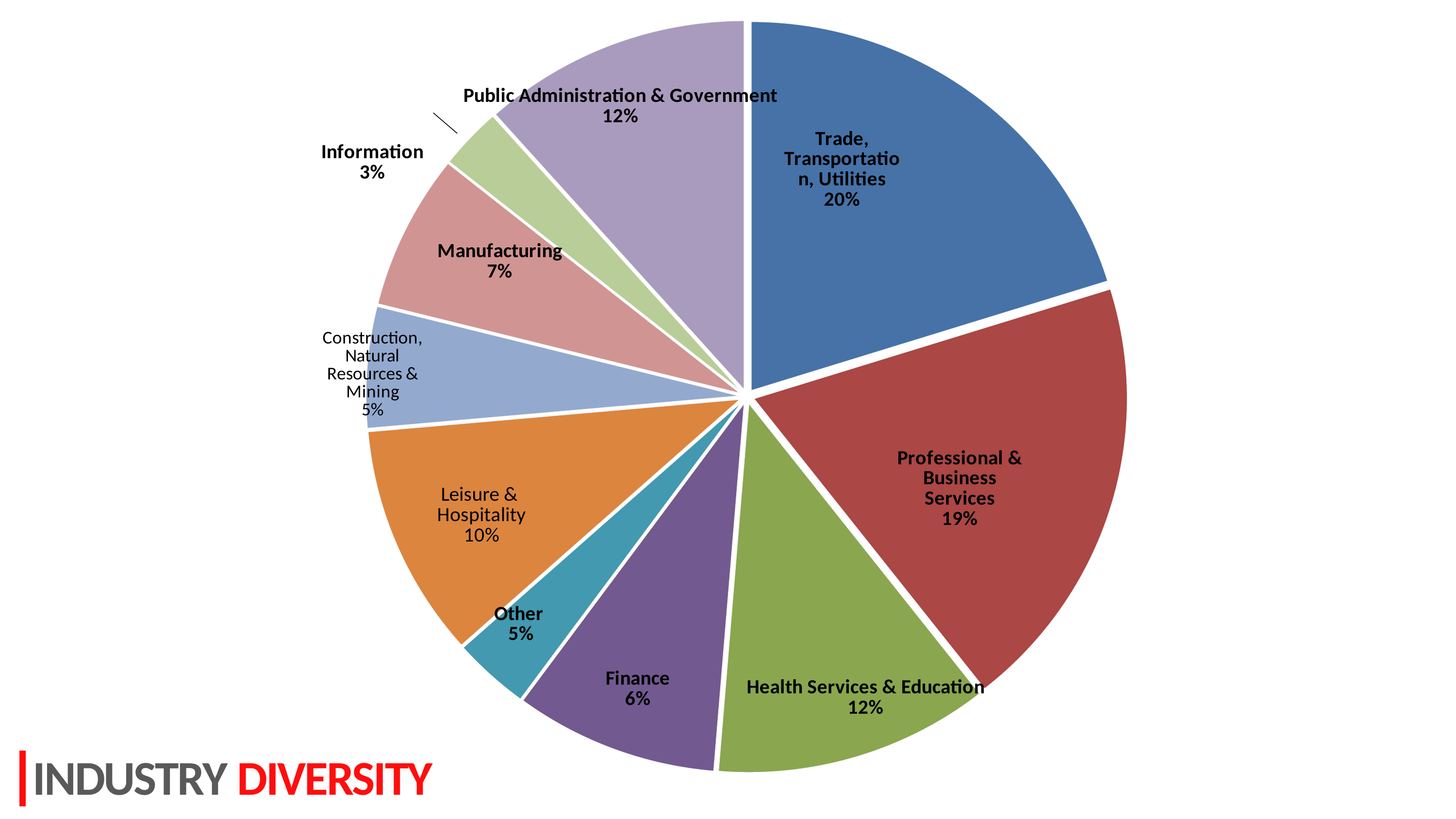
What percentage is shown for Professional & Business Services? 19% How many slices does the pie chart have? 10 What is the title text shown at the bottom left of the slide? INDUSTRY DIVERSITY What kind of chart is shown on the slide? Pie chart Which industry has the smallest slice of the pie? Information Which is larger, the share for Leisure & Hospitality or the share for Manufacturing? Leisure & Hospitality What percentage is shown for Construction, Natural Resources & Mining? 5% What percentage is shown for Leisure & Hospitality? 10% What is the difference in percentage points between Health Services & Education and Finance? 6 Which industry has the largest slice of the pie? Trade, Transportation, Utilities What percentage is shown for Manufacturing? 7% What share of the pie does Trade, Transportation, Utilities hold? 20%